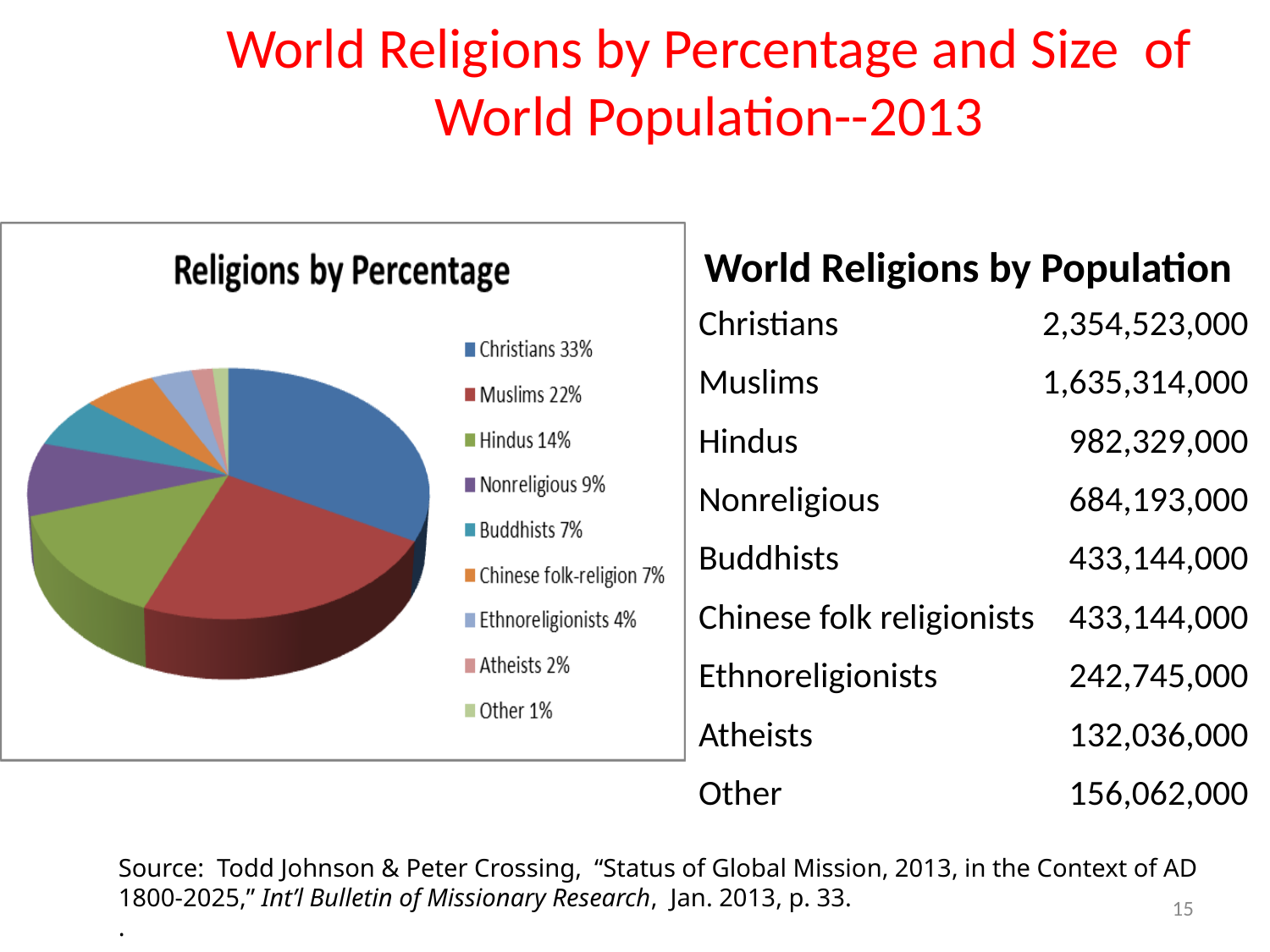
What percentage does the chart show for Muslims? 22% What is the difference in percentage points between Christians and Muslims in the chart? 11 Which category has the largest slice of the pie? Christians What is the title of the chart? Religions by Percentage What percentage does the chart show for Ethnoreligionists? 4% What percentage does the chart show for Nonreligious? 9% What type of chart is shown on the slide? pie chart What percentage does the chart show for Christians? 33% Which category has the smallest slice of the pie? Other Which is larger in the chart, the share for Buddhists or the share for Atheists? Buddhists How many categories does the pie chart legend list? 9 What percentage does the chart show for Hindus? 14%